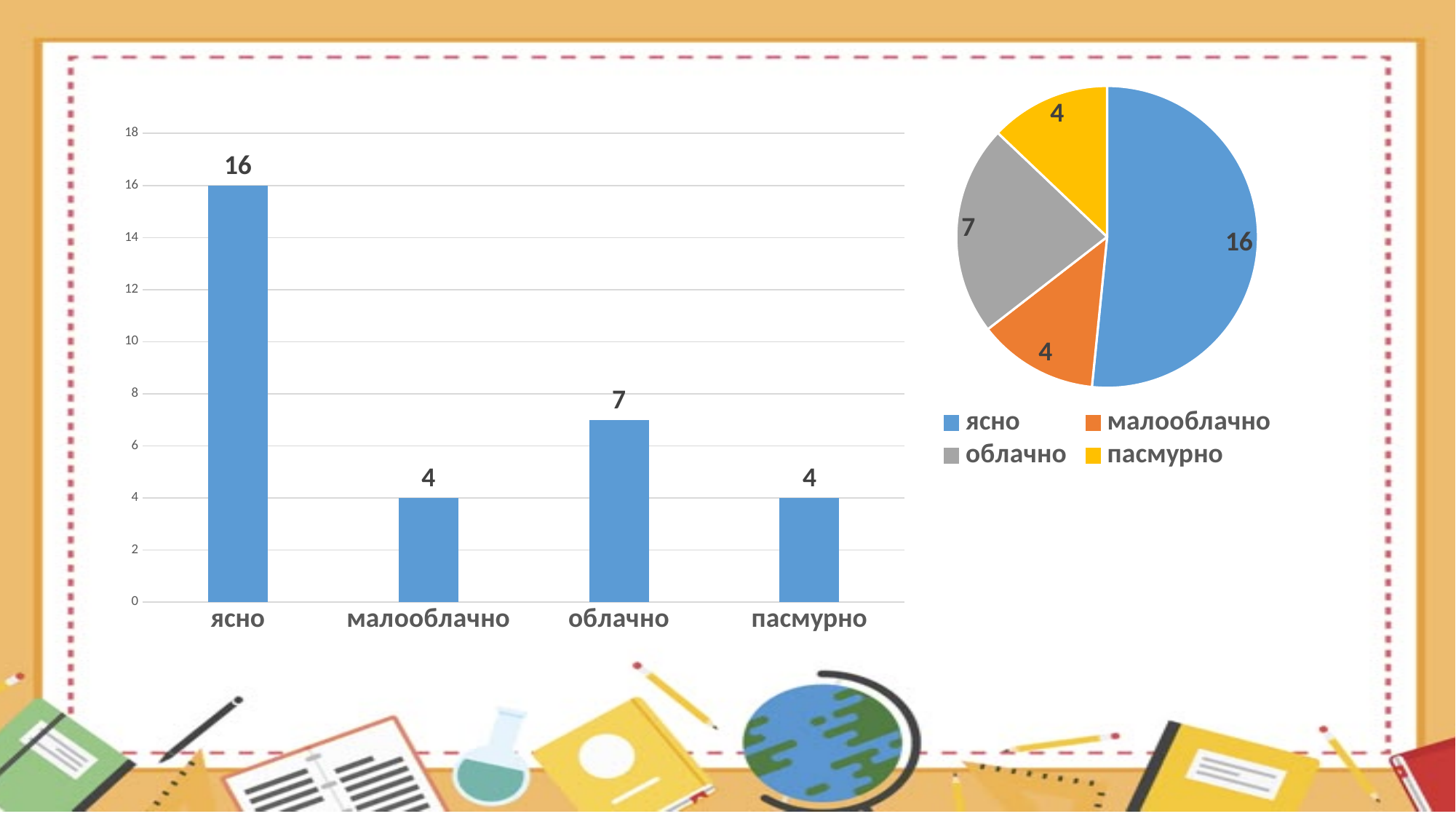
In the pie chart on the right, what is the value of the малооблачно slice? 4 In the bar chart on the left, is the value for ясно greater or less than 10? greater What kind of chart is the chart on the left of the slide? bar chart In the bar chart on the left, which is larger, the value for облачно or the value for малооблачно? облачно In the bar chart on the left, what is the difference between the values for облачно and пасмурно? 3 How many entries does the legend of the pie chart on the right list? 4 In the bar chart on the left, what is the value for ясно? 16 How many categories are shown in the bar chart on the left? 4 In the bar chart on the left, what is the difference between the values for ясно and облачно? 9 In the bar chart on the left, which category has the highest value? ясно In the pie chart on the right, which category has the largest slice? ясно In the bar chart on the left, what is the value for облачно? 7